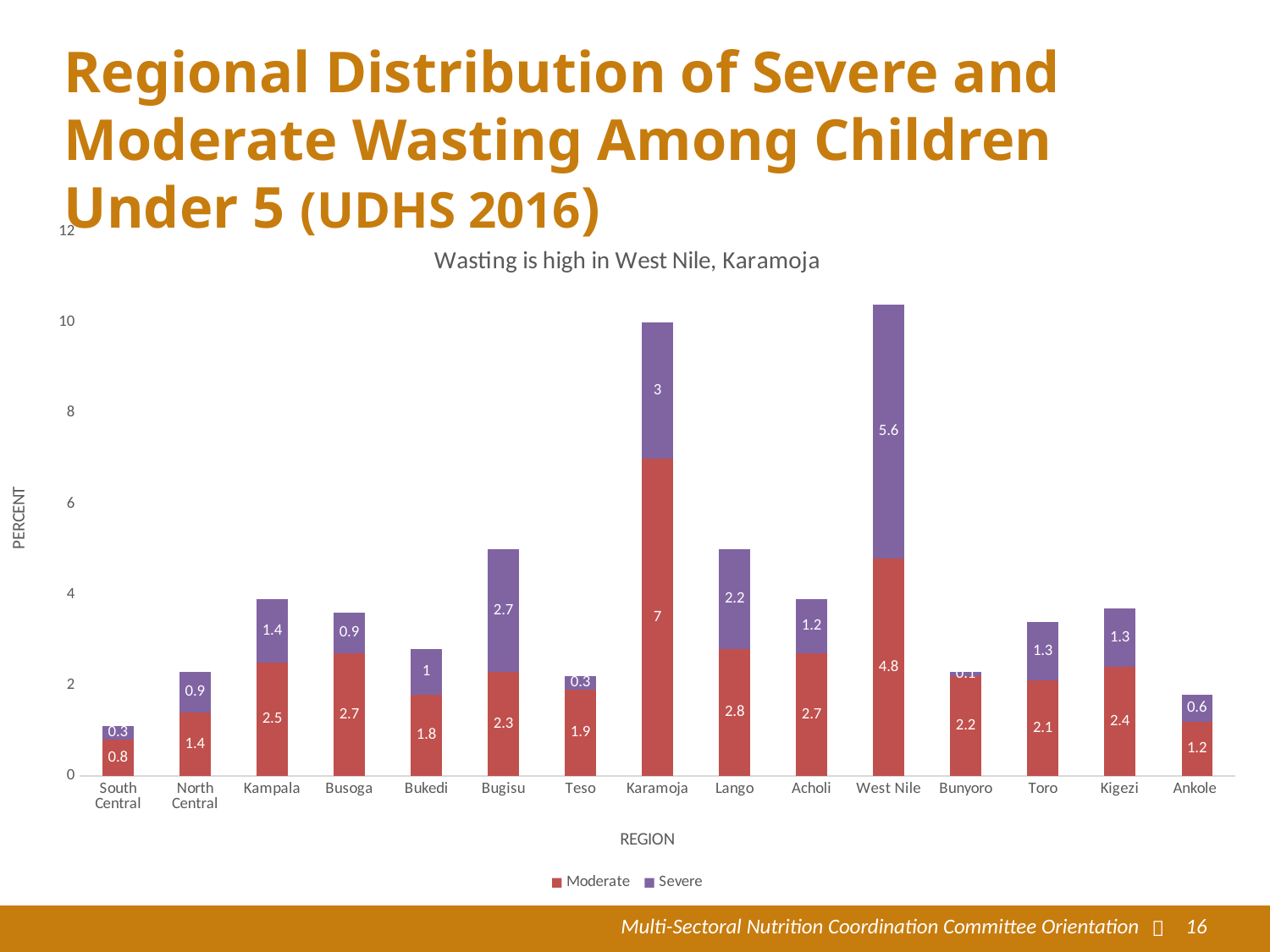
What is the Moderate wasting value for Karamoja? 7 What is the total (Moderate plus Severe) wasting for Karamoja? 10 What subtitle appears above the chart? Wasting is high in West Nile, Karamoja How many regions are shown on the x axis of the chart? 15 What is the difference between the Severe wasting values for Bugisu and Kampala? 1.3 Which region has the highest Moderate wasting value? Karamoja What is the total (Moderate plus Severe) wasting for West Nile? 10.4 Which region has the larger Moderate wasting value, Busoga or Bukedi? Busoga What kind of chart is shown on the slide? Stacked bar chart How many series does the legend list? 2 Which region has the lowest Severe wasting value? Bunyoro What is the Severe wasting value for West Nile? 5.6